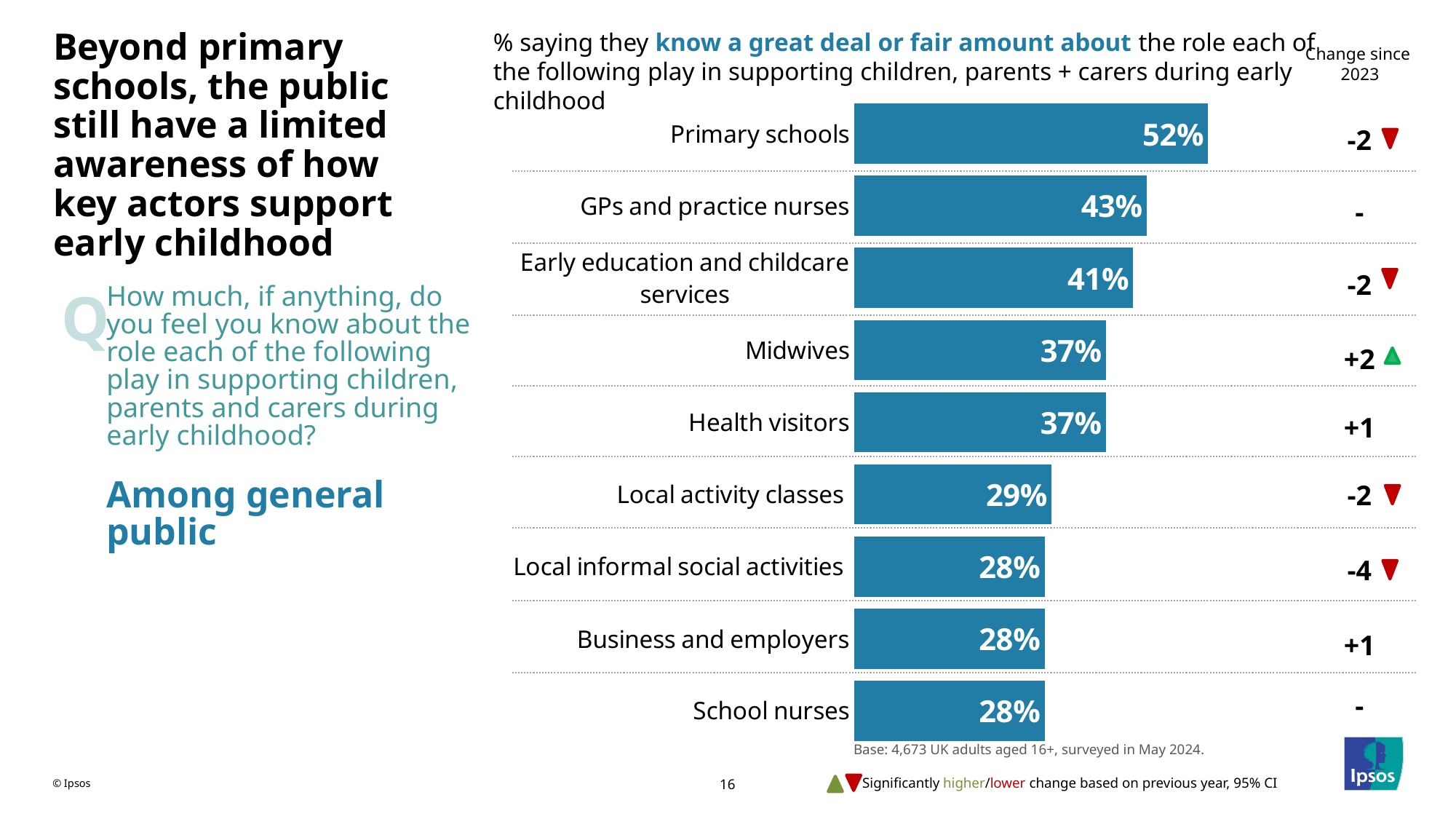
What kind of chart is shown on the slide? Bar chart What is the change since 2023 shown for midwives? +2 What is the difference in percentage points between primary schools and GPs and practice nurses? 9 What is the difference in percentage points between early education and childcare services and local activity classes? 12 What percentage say they know a great deal or fair amount about the role of primary schools? 52% What percentage say they know a great deal or fair amount about the role of midwives? 37% What is the base size stated below the chart? 4,673 UK adults aged 16+ Which is larger: the value for health visitors or the value for local informal social activities? Health visitors How many categories are shown in the chart? 9 What percentage say they know a great deal or fair amount about the role of GPs and practice nurses? 43% Which category has the highest percentage in the chart? Primary schools What is the change since 2023 shown for local informal social activities? -4